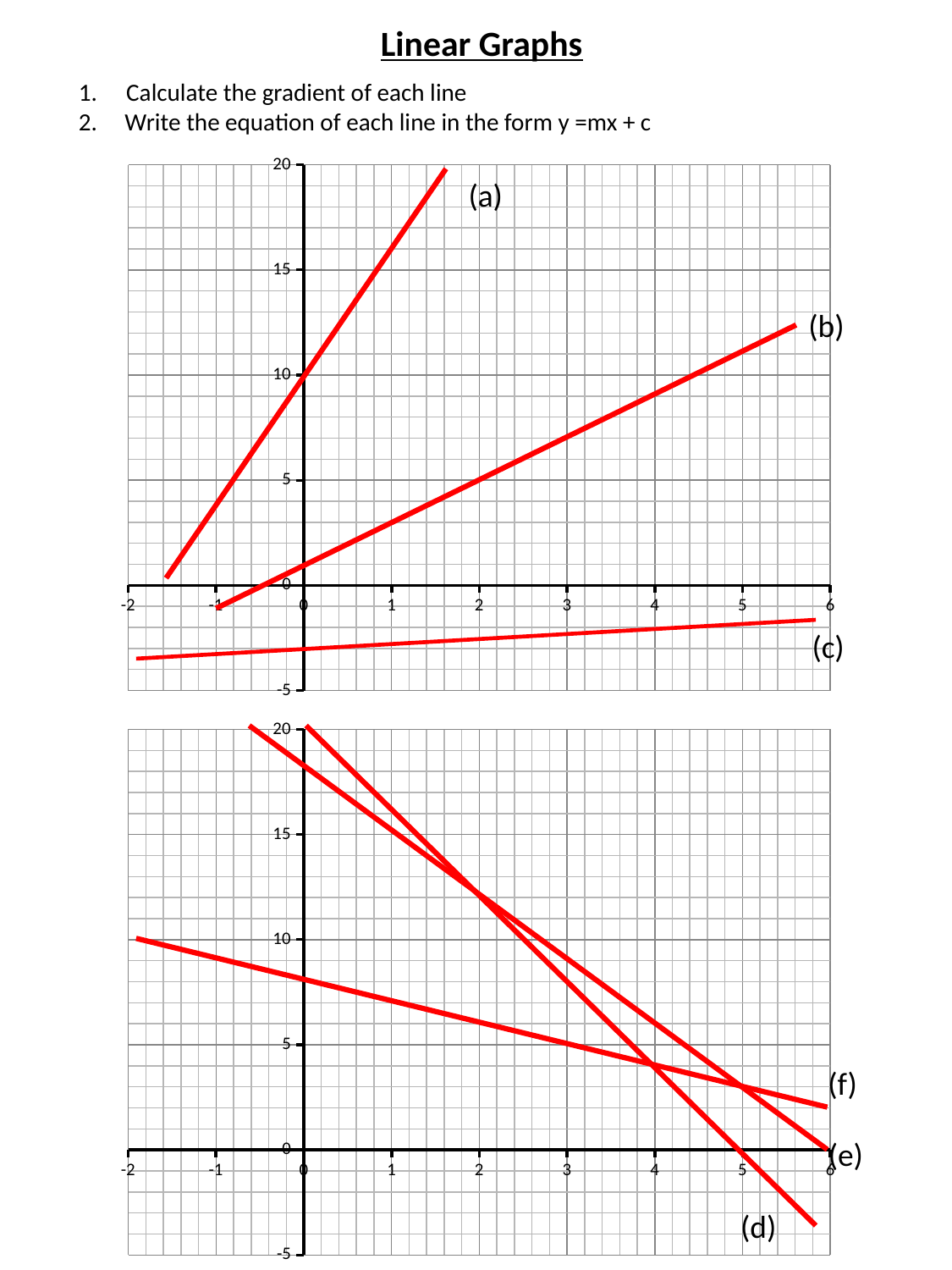
On the top chart, at what y value does line (a) cross the y axis? 10 On the top chart, is the value of line (c) at x = 0 greater or less than 0? less On the bottom chart, is the value of line (f) at x = 0 greater or less than 5? greater On the bottom chart, at x = 0, which line has the higher value, (d) or (f)? (d) On the bottom chart, at what x value does line (d) cross the x axis? 5 On the bottom chart, does line (d) rise or fall as x increases? fall How many lines are plotted on the bottom chart? 3 How many lines are plotted on the top chart? 3 What kind of chart is shown on the slide? line chart On the bottom chart, is the value of line (e) at x = 4 greater or less than 10? less What is the title of the slide? Linear Graphs On the top chart, does line (a) rise or fall as x increases? rise